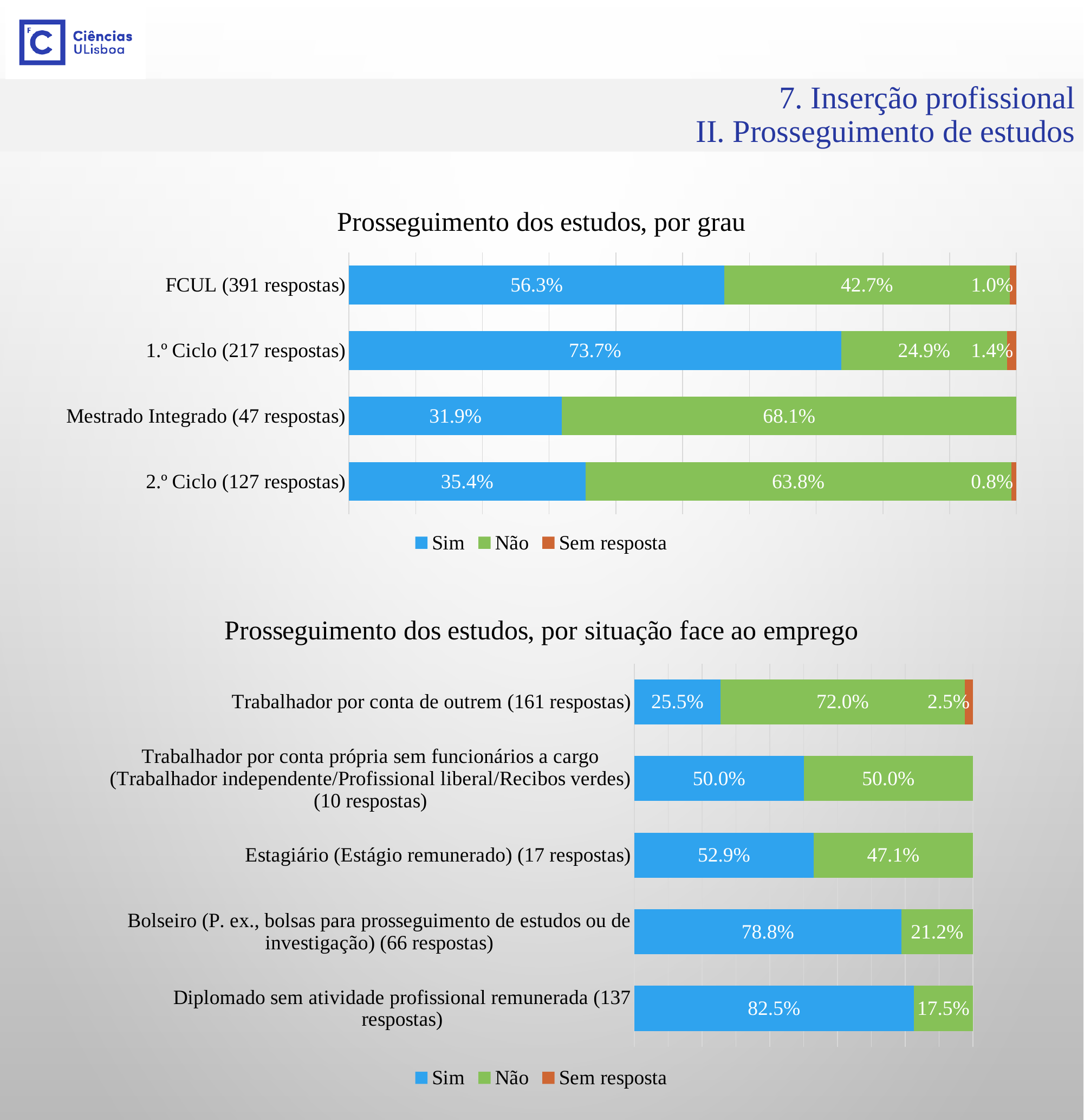
In the chart 'Prosseguimento dos estudos, por grau', how many series does the legend list? 3 In the chart 'Prosseguimento dos estudos, por grau', which category has the highest 'Sim' value? 1.º Ciclo (217 respostas) In the chart 'Prosseguimento dos estudos, por grau', what is the 'Sim' value for FCUL (391 respostas)? 56.3% In the chart 'Prosseguimento dos estudos, por grau', what is the difference between the 'Sim' values for 1.º Ciclo and 2.º Ciclo? 38.3% In the chart 'Prosseguimento dos estudos, por grau', which category has the lowest 'Sim' value? Mestrado Integrado (47 respostas) In the chart 'Prosseguimento dos estudos, por situação face ao emprego', is the 'Não' value larger for Trabalhador por conta de outrem or for Estagiário? Trabalhador por conta de outrem In the chart 'Prosseguimento dos estudos, por situação face ao emprego', what is the 'Sim' value for Bolseiro (66 respostas)? 78.8% What kind of chart is 'Prosseguimento dos estudos, por situação face ao emprego'? Stacked bar chart In the chart 'Prosseguimento dos estudos, por situação face ao emprego', which category has the highest 'Sim' value? Diplomado sem atividade profissional remunerada (137 respostas) In the chart 'Prosseguimento dos estudos, por grau', how many categories are shown? 4 In the chart 'Prosseguimento dos estudos, por situação face ao emprego', what is the 'Sem resposta' value for Trabalhador por conta de outrem (161 respostas)? 2.5% In the chart 'Prosseguimento dos estudos, por grau', what is the 'Não' value for Mestrado Integrado (47 respostas)? 68.1%